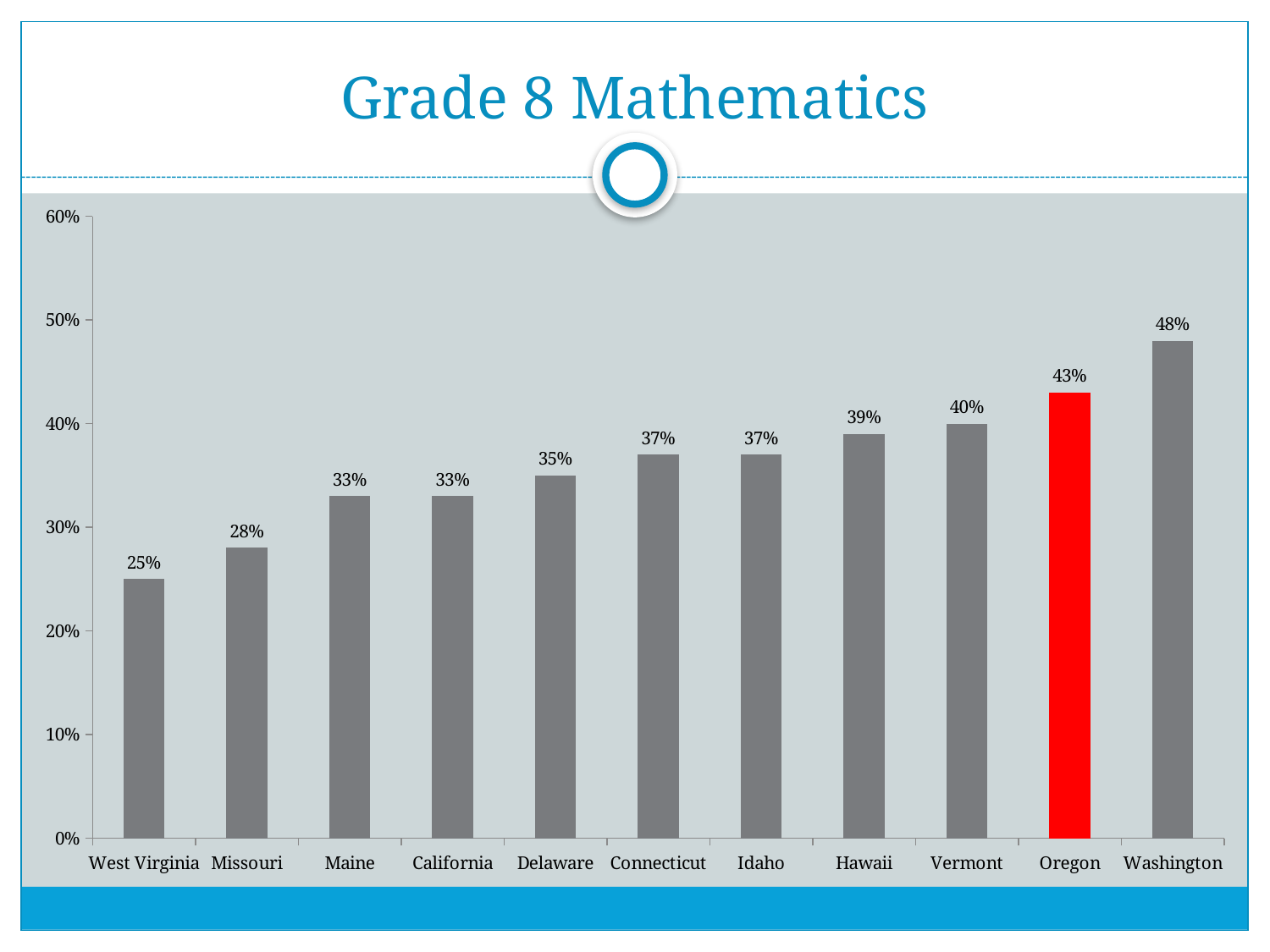
Is the value for Maine greater or less than 30%? greater What is the value for Hawaii? 39% What is the difference between the values for Vermont and Missouri? 12% Which state's bar is coloured red? Oregon What is the value for West Virginia? 25% What kind of chart is shown on the slide? bar chart How many states are shown on the chart? 11 Which state has the highest value? Washington What is the difference between the values for Washington and Oregon? 5% What is the value for Oregon? 43% Which is larger, the value for Delaware or the value for Hawaii? Hawaii Which state has the lowest value? West Virginia